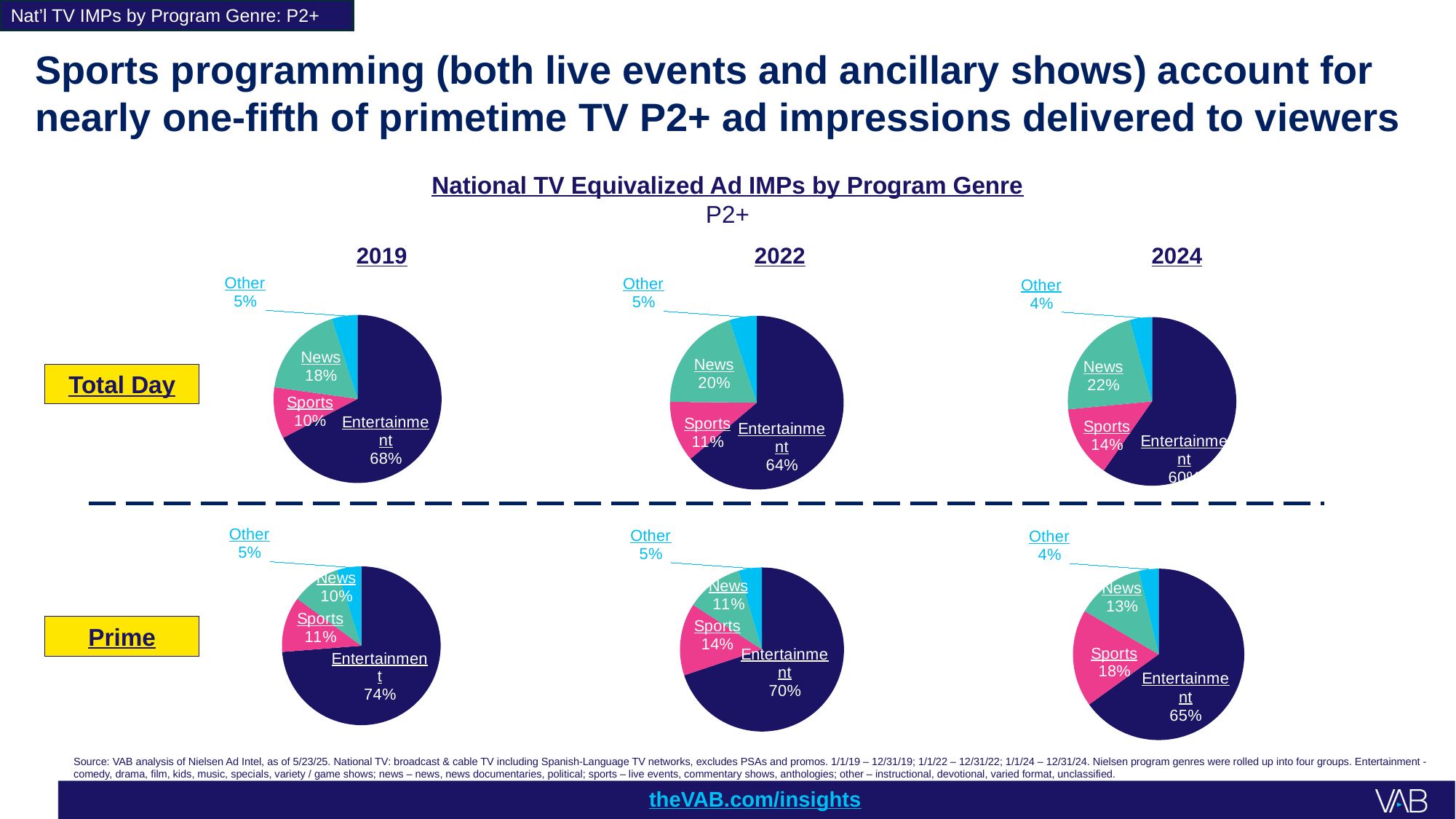
Across the Prime pie charts, does the Sports share rise or fall from 2019 to 2024? Rise How many slices does the Total Day 2019 pie chart have? 4 In the Total Day 2019 pie chart, what share of ad impressions does Entertainment account for? 68% In the Total Day 2022 pie chart, what is the combined share of Sports and News? 31% What kind of chart is used to show the Prime 2022 data? Pie chart In the Total Day 2022 pie chart, which genre has the largest share? Entertainment In the Total Day 2024 pie chart, what is the share for News? 22% In the Prime 2024 pie chart, which is larger, the Sports share or the News share? Sports In the Prime 2019 pie chart, which genre has the smallest share? Other What is the title shown above the six pie charts? National TV Equivalized Ad IMPs by Program Genre In the Prime 2024 pie chart, what share of ad impressions does Sports account for? 18% In the Prime 2022 pie chart, what is the difference between the Entertainment share and the Sports share? 56%